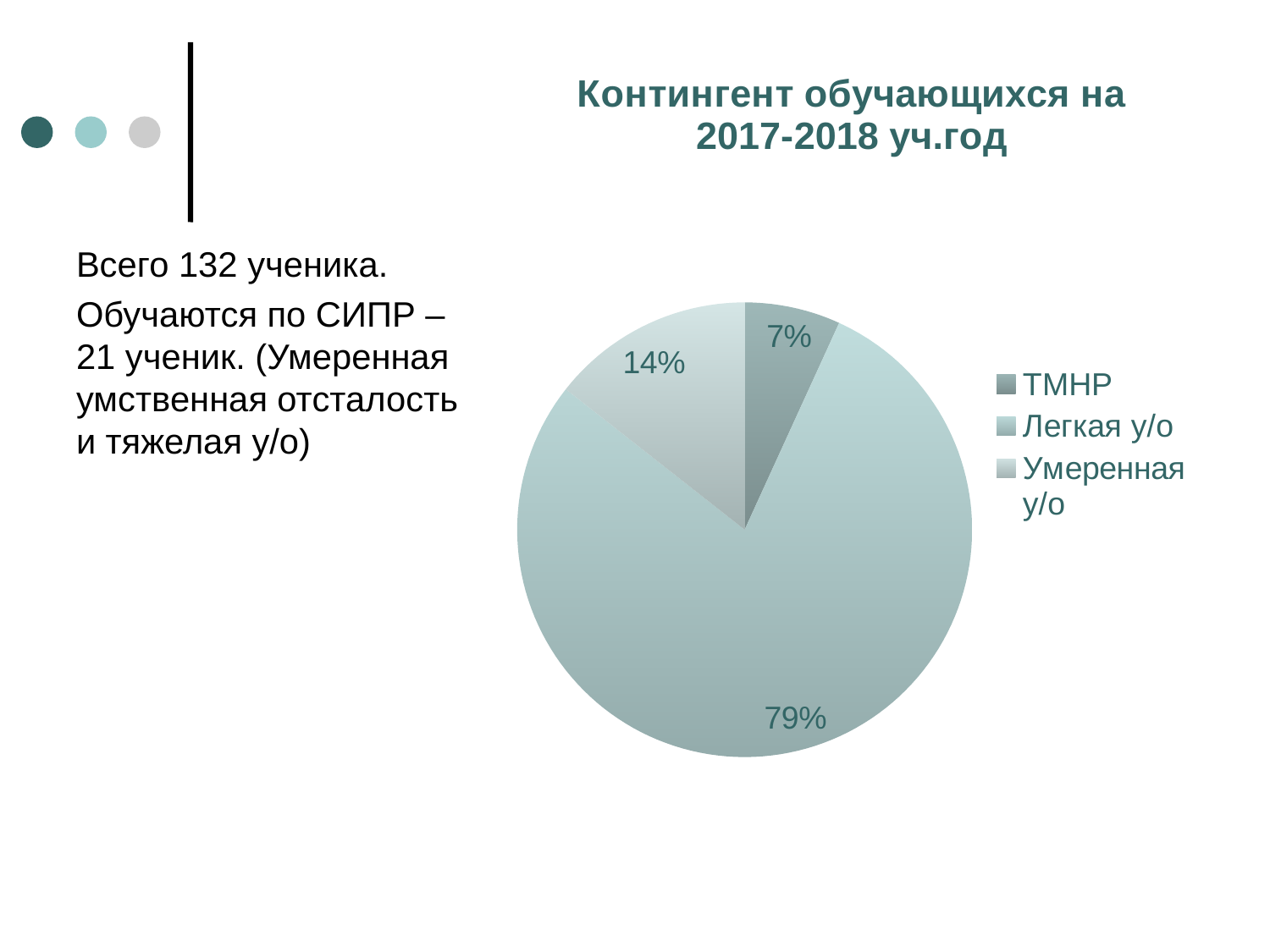
What share of the pie does Умеренная у/о have? 14% How many entries does the legend list? 3 What kind of chart is shown on the slide? pie chart Which category has the largest slice of the pie? Легкая у/о Which is larger, the share for Умеренная у/о or the share for ТМНР? Умеренная у/о What is the difference in percentage points between Легкая у/о and Умеренная у/о? 65 Which category has the smallest slice of the pie? ТМНР How many categories does the pie chart show? 3 What is the title of the chart? Контингент обучающихся на 2017-2018 уч.год What is the difference in percentage points between Умеренная у/о and ТМНР? 7 What share of the pie does Легкая у/о have? 79% What share of the pie does ТМНР have? 7%